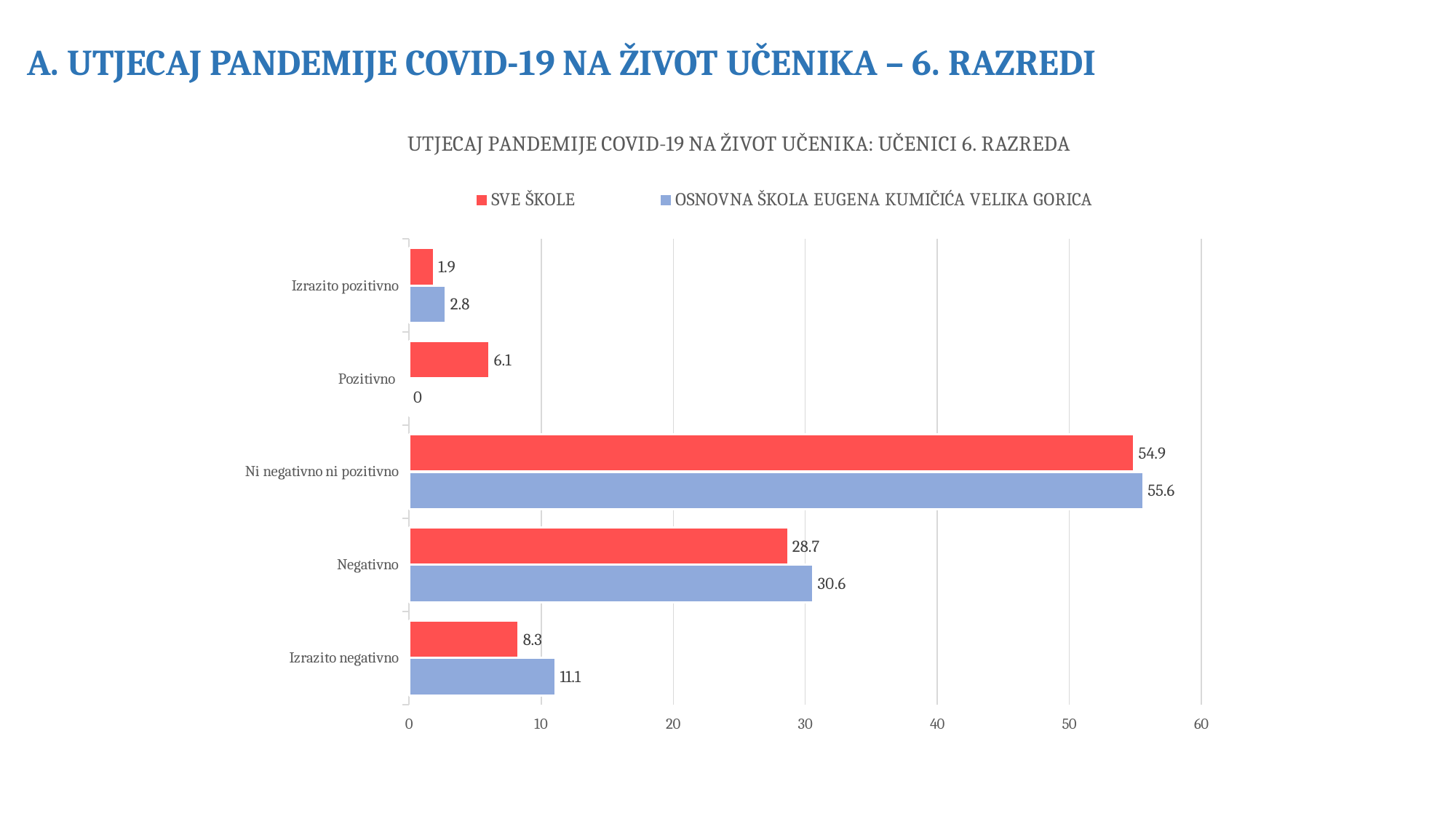
How many categories are shown on the chart? 5 What is the difference between the OSNOVNA ŠKOLA EUGENA KUMIČIĆA VELIKA GORICA and SVE ŠKOLE values in the Negativno category? 1.9 What kind of chart is shown on the slide? bar chart Which category has the highest value for SVE ŠKOLE? Ni negativno ni pozitivno What is the value for OSNOVNA ŠKOLA EUGENA KUMIČIĆA VELIKA GORICA in the Pozitivno category? 0 Is the value for SVE ŠKOLE in the Ni negativno ni pozitivno category greater or less than 50? greater What is the value for SVE ŠKOLE in the Negativno category? 28.7 What is the value for OSNOVNA ŠKOLA EUGENA KUMIČIĆA VELIKA GORICA in the Izrazito negativno category? 11.1 In the Izrazito negativno category, which series has the larger value: SVE ŠKOLE or OSNOVNA ŠKOLA EUGENA KUMIČIĆA VELIKA GORICA? OSNOVNA ŠKOLA EUGENA KUMIČIĆA VELIKA GORICA How many series does the legend list? 2 What colour are the bars for the SVE ŠKOLE series? red Which category has the lowest value for SVE ŠKOLE? Izrazito pozitivno